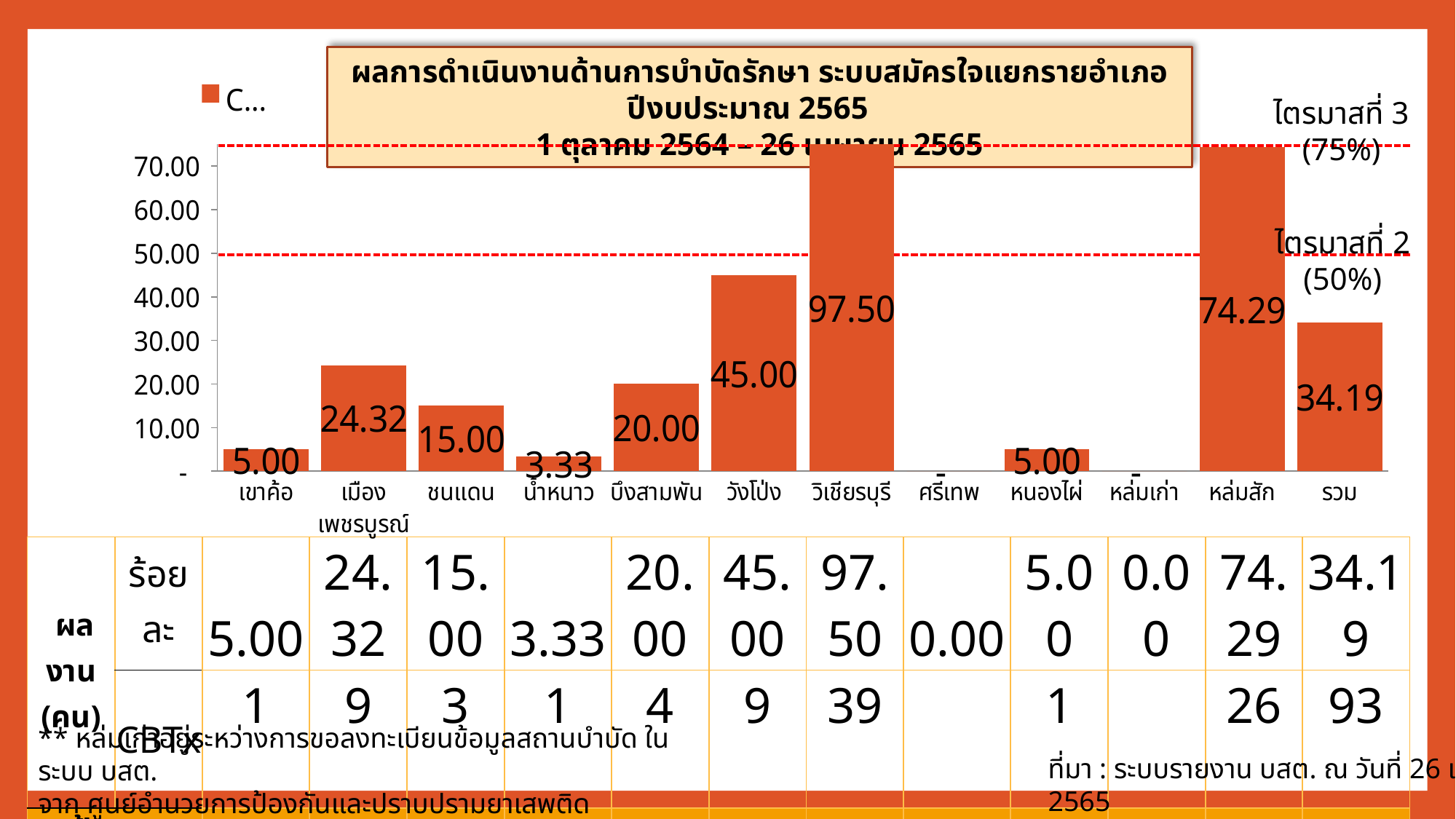
How many categories are shown on the x axis? 12 What percentage is marked by the upper dashed reference line labelled ไตรมาสที่ 3? 75% What is the value shown for รวม? 34.19 What is the value shown for หล่มสัก? 74.29 Which category has the highest value? วิเชียรบุรี What is the difference between the values for ชนแดน and น้ำหนาว? 11.67 What kind of chart is shown on the slide? bar chart What is the difference between the values for วิเชียรบุรี and หล่มสัก? 23.21 What is the value shown for วิเชียรบุรี? 97.50 Is the value for วังโป่ง greater or less than 50.00? less Which is larger, the value for วังโป่ง or the value for บึงสามพัน? วังโป่ง What is the value shown for เมืองเพชรบูรณ์? 24.32